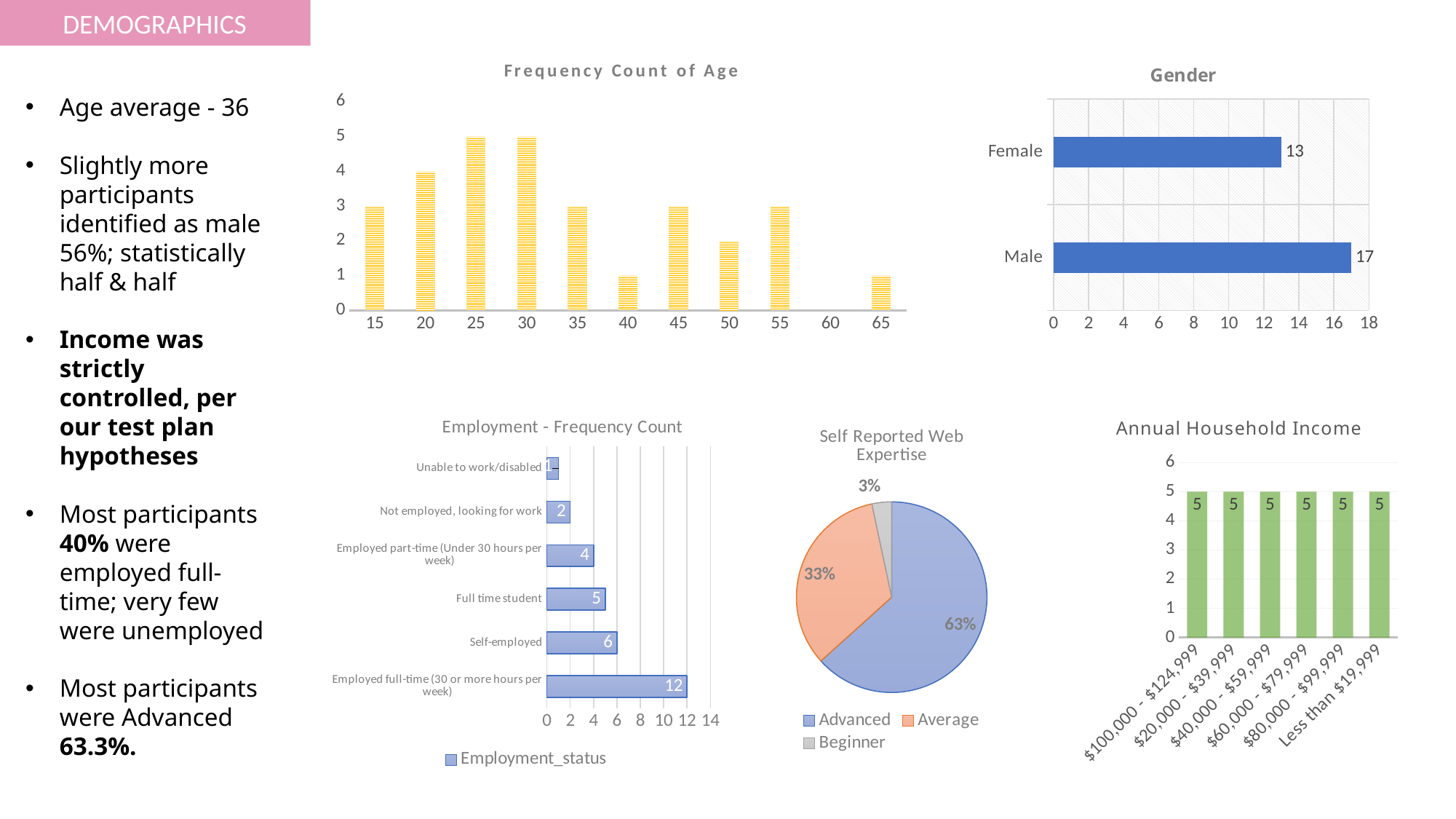
In the Employment - Frequency Count chart, which category has the highest value? Employed full-time (30 or more hours per week) In the Employment - Frequency Count chart, what is the value for Self-employed? 6 In the Gender chart, what is the difference between the Male and Female values? 4 In the Self Reported Web Expertise chart, what share of the pie is Average? 33% In the Employment - Frequency Count chart, which category has the lowest value? Unable to work/disabled In the Frequency Count of Age chart, how many age categories are shown on the x axis? 11 In the Gender chart, what is the value for Male? 17 What kind of chart is the Annual Household Income chart? Bar chart In the Self Reported Web Expertise chart, which slice is the smallest? Beginner In the Employment - Frequency Count chart, how many categories are shown? 6 In the Annual Household Income chart, what is the value for $40,000 - $59,999? 5 In the Frequency Count of Age chart, is the value for 20 greater or less than 3? greater